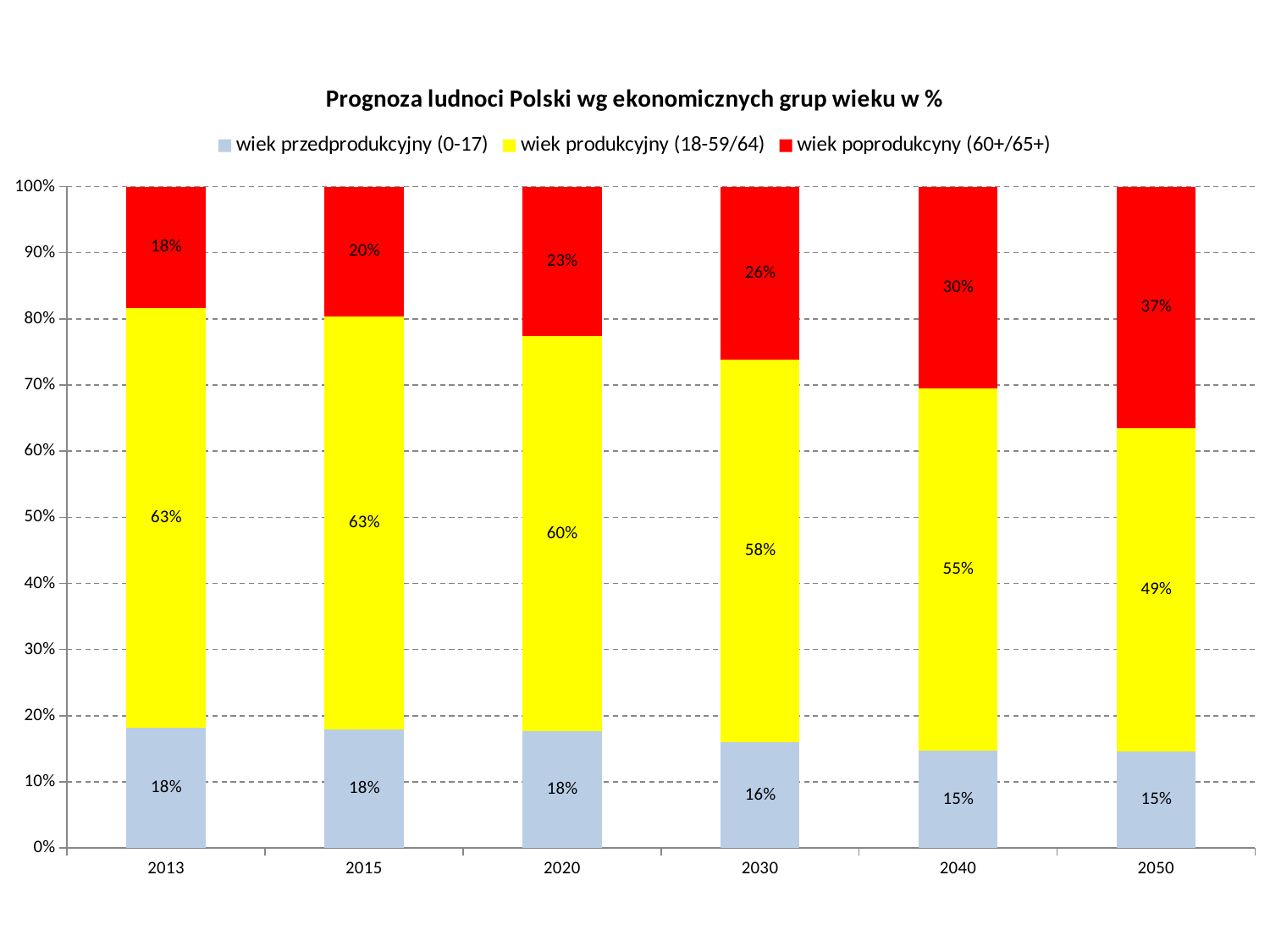
What is the value for wiek przedprodukcyjny (0-17) in 2040? 15% What is the value for wiek poprodukcyny (60+/65+) in 2050? 37% What is the difference between the wiek poprodukcyny (60+/65+) values for 2050 and 2013? 19% What is the value for wiek produkcyjny (18-59/64) in 2030? 58% How many series does the legend list? 3 What kind of chart is shown on the slide? stacked bar chart Which is larger in 2040: wiek produkcyjny (18-59/64) or wiek poprodukcyny (60+/65+)? wiek produkcyjny (18-59/64) How many years are shown on the x axis? 6 What is the title of the chart? Prognoza ludnoci Polski wg ekonomicznych grup wieku w % In which year is the wiek produkcyjny (18-59/64) share lowest? 2050 In which year is the wiek poprodukcyny (60+/65+) share highest? 2050 Does the wiek poprodukcyny (60+/65+) share rise or fall from 2013 to 2050? rise